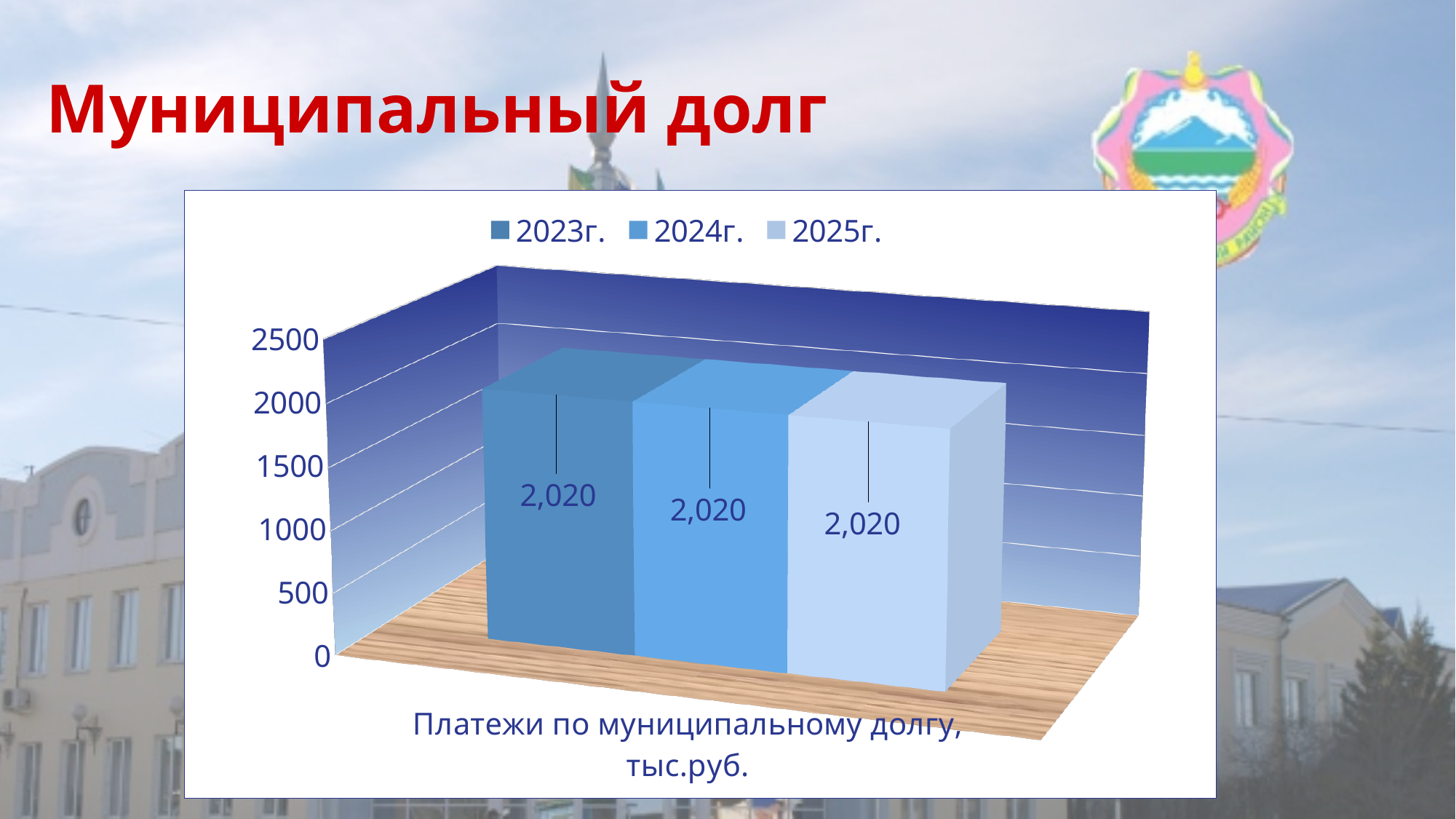
What is the category label shown below the bars? Платежи по муниципальному долгу, тыс.руб. Is the value for 2024г. greater or less than 1500? greater How many categories are shown on the x axis? 1 What is the value for 2024г. in the chart? 2,020 What is the value for 2023г. in the chart? 2,020 How many series does the legend list? 3 Do the values rise, fall or stay the same from 2023г. to 2025г.? Stay the same Is the value for 2025г. greater or less than 2500? less What is the difference between the values for 2023г. and 2025г.? 0 What are the three entries listed in the legend? 2023г., 2024г., 2025г. What kind of chart is shown on the slide? Bar chart What is the value for 2025г. in the chart? 2,020